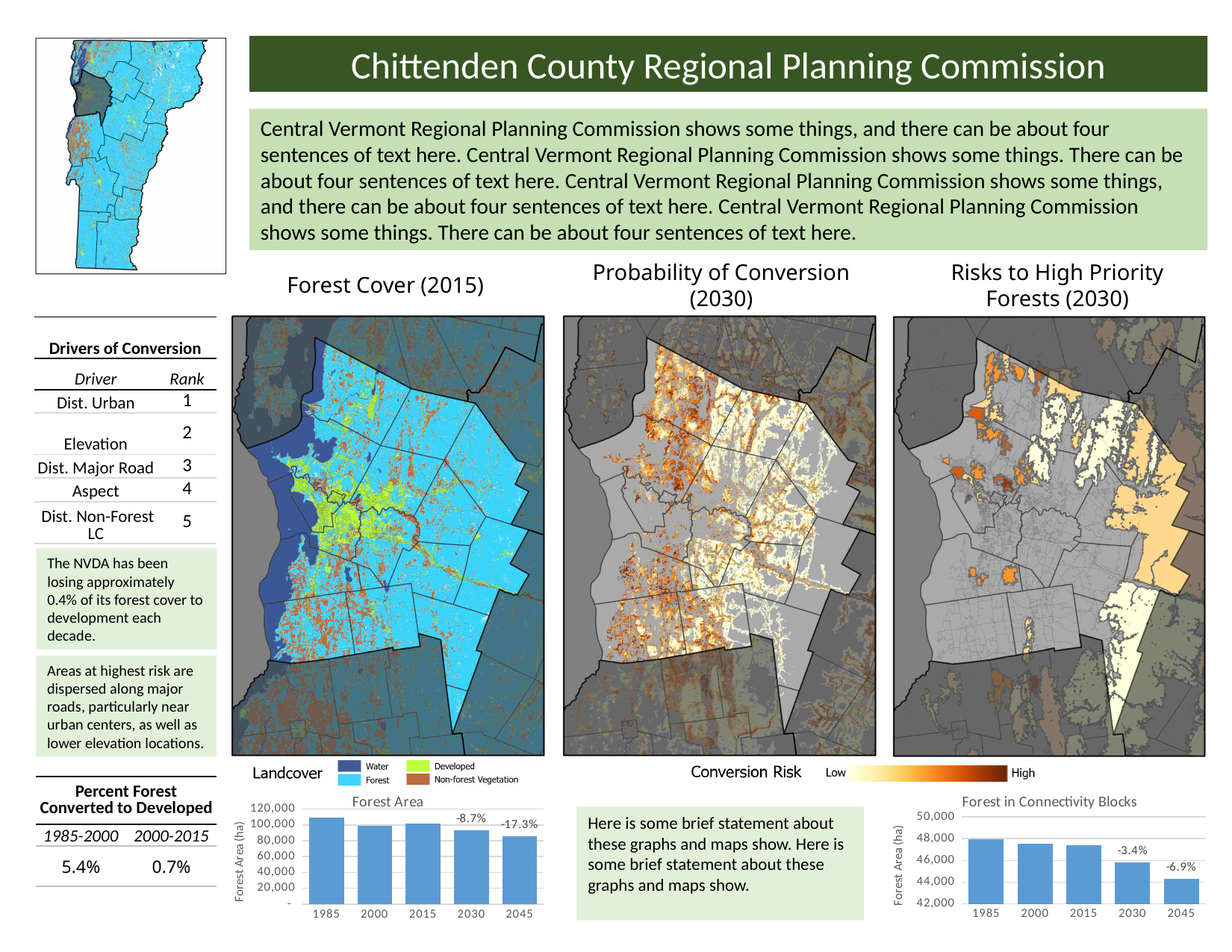
In the Forest Area chart, is the value for 1985 greater or less than 100,000? greater In the Forest in Connectivity Blocks chart, is the value for 2045 greater or less than 46,000? less In the Forest in Connectivity Blocks chart, which year has the lowest value? 2045 How many years are plotted on the x axis of the Forest Area chart? 5 In the Forest Area chart, what data label is shown on the 2045 bar? -17.3% In the Forest Area chart, what data label is shown on the 2030 bar? -8.7% In the Forest Area chart, which year has the lowest forest area? 2045 In the Forest Area chart, which year has the highest forest area? 1985 What kind of chart is the Forest in Connectivity Blocks chart? Bar chart In the Forest in Connectivity Blocks chart, do the values generally rise or fall from 1985 to 2045? Fall In the Forest in Connectivity Blocks chart, what data label is shown on the 2045 bar? -6.9% In the Forest in Connectivity Blocks chart, what data label is shown on the 2030 bar? -3.4%